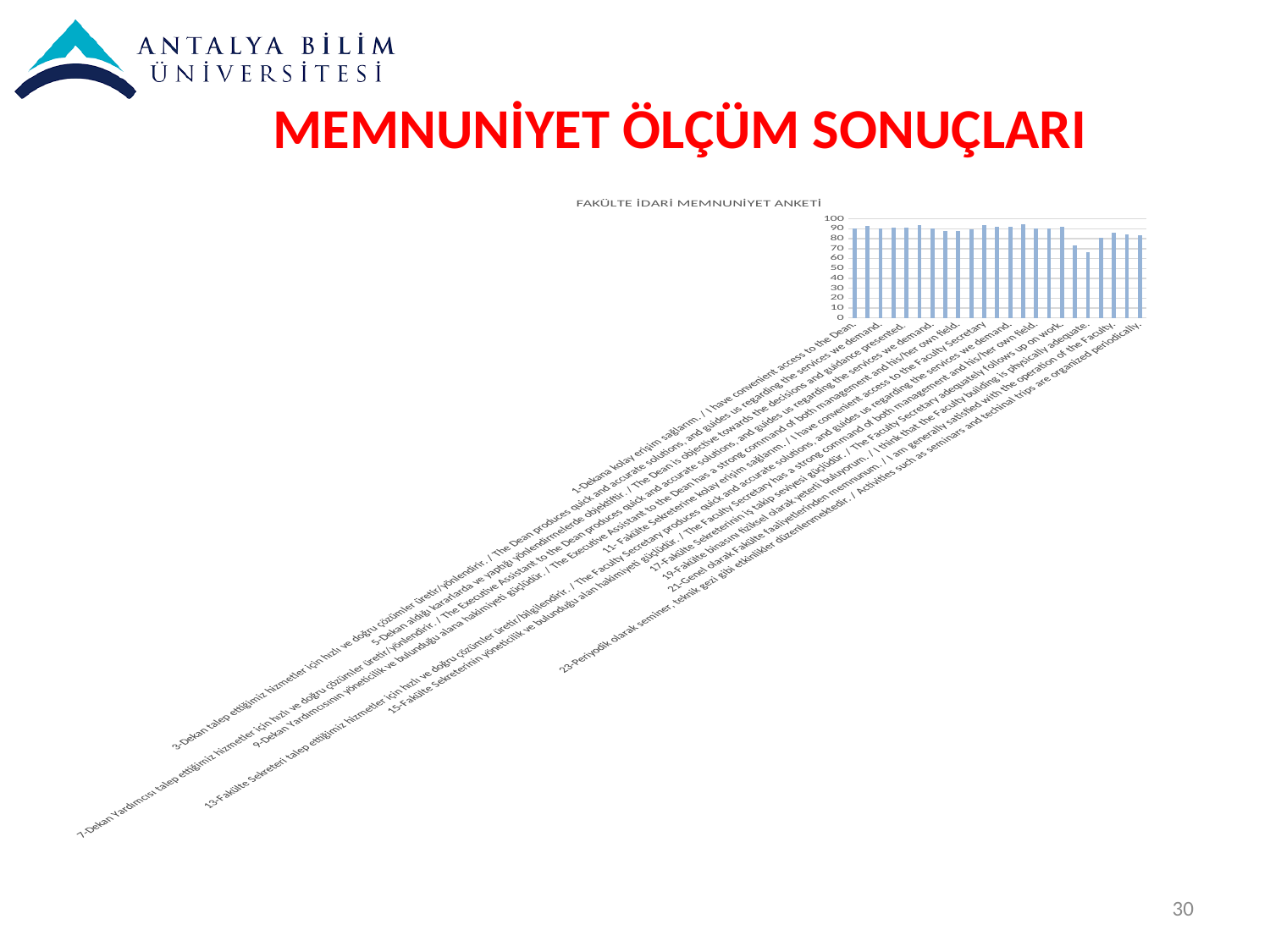
Is the value for "23-Periyodik olarak seminer, teknik gezi gibi etkinlikler düzenlenmektedir" greater or less than 50? greater Are all of the bars in the chart above 50? yes What kind of chart is shown on the slide? bar chart Is the value for "3-Dekan talep ettiğimiz hizmetler için hızlı ve doğru çözümler üretir/yönlendirir" greater or less than 60? greater What is the highest value shown on the chart's vertical axis? 100 What is the title of the chart? FAKÜLTE İDARİ MEMNUNİYET ANKETİ